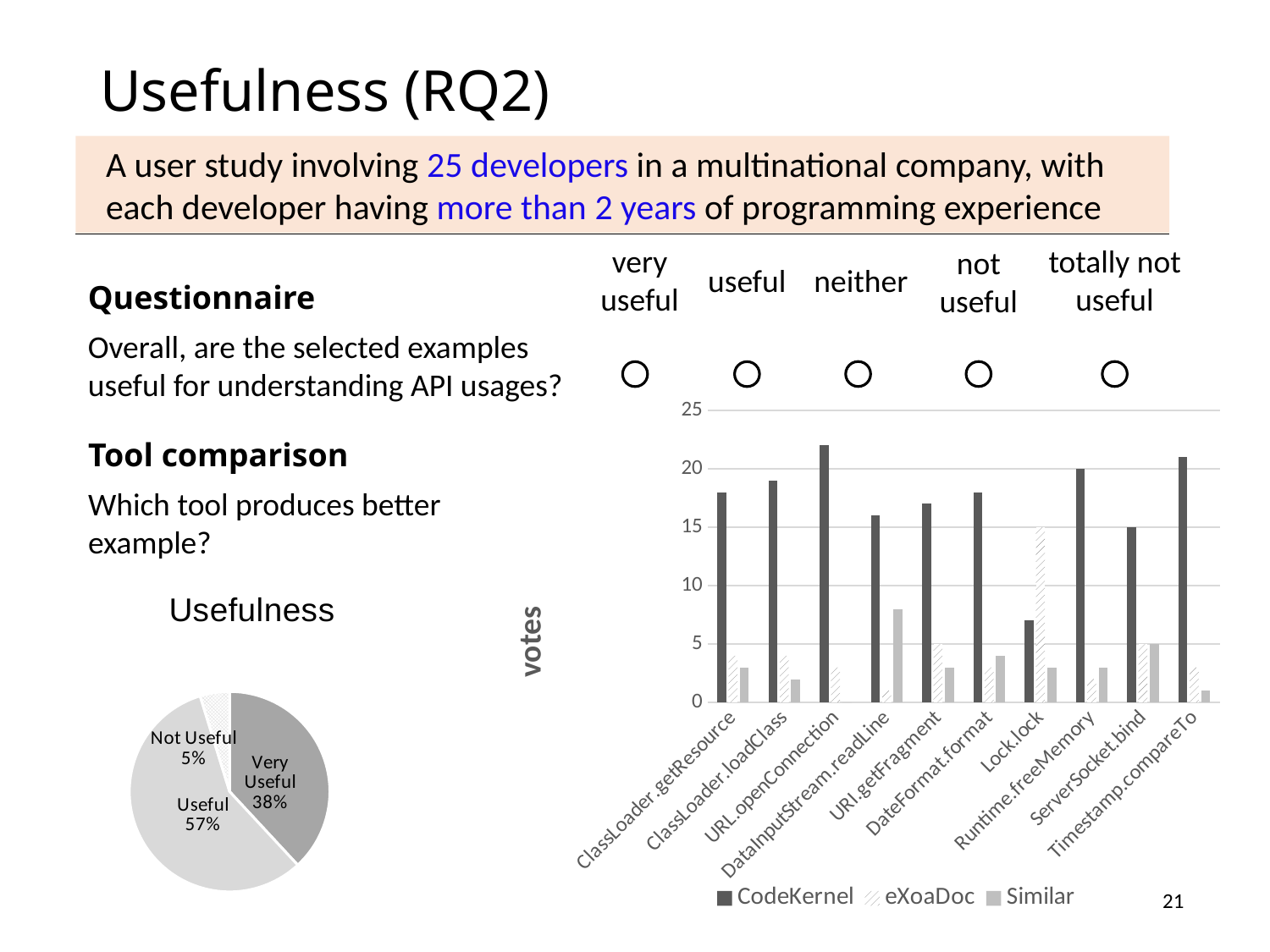
In the votes bar chart, for Lock.lock, which is larger: the CodeKernel value or the eXoaDoc value? eXoaDoc In the Usefulness pie chart, what share of responses is Useful? 57% In the Usefulness pie chart, what share of responses is Very Useful? 38% In the Usefulness pie chart, which category has the smallest share? Not Useful In the votes bar chart, for which category is the CodeKernel value lowest? Lock.lock What type of chart is the Usefulness chart on the lower left of the slide? pie chart What type of chart is the votes chart on the right of the slide? bar chart In the Usefulness pie chart, how many percentage points larger is the Useful share than the Very Useful share? 19 In the Usefulness pie chart, which category has the largest share? Useful In the votes bar chart, how many series does the legend list? 3 In the votes bar chart, is the CodeKernel value for URL.openConnection greater or less than 20? greater In the votes bar chart, how many API categories are shown on the x axis? 10